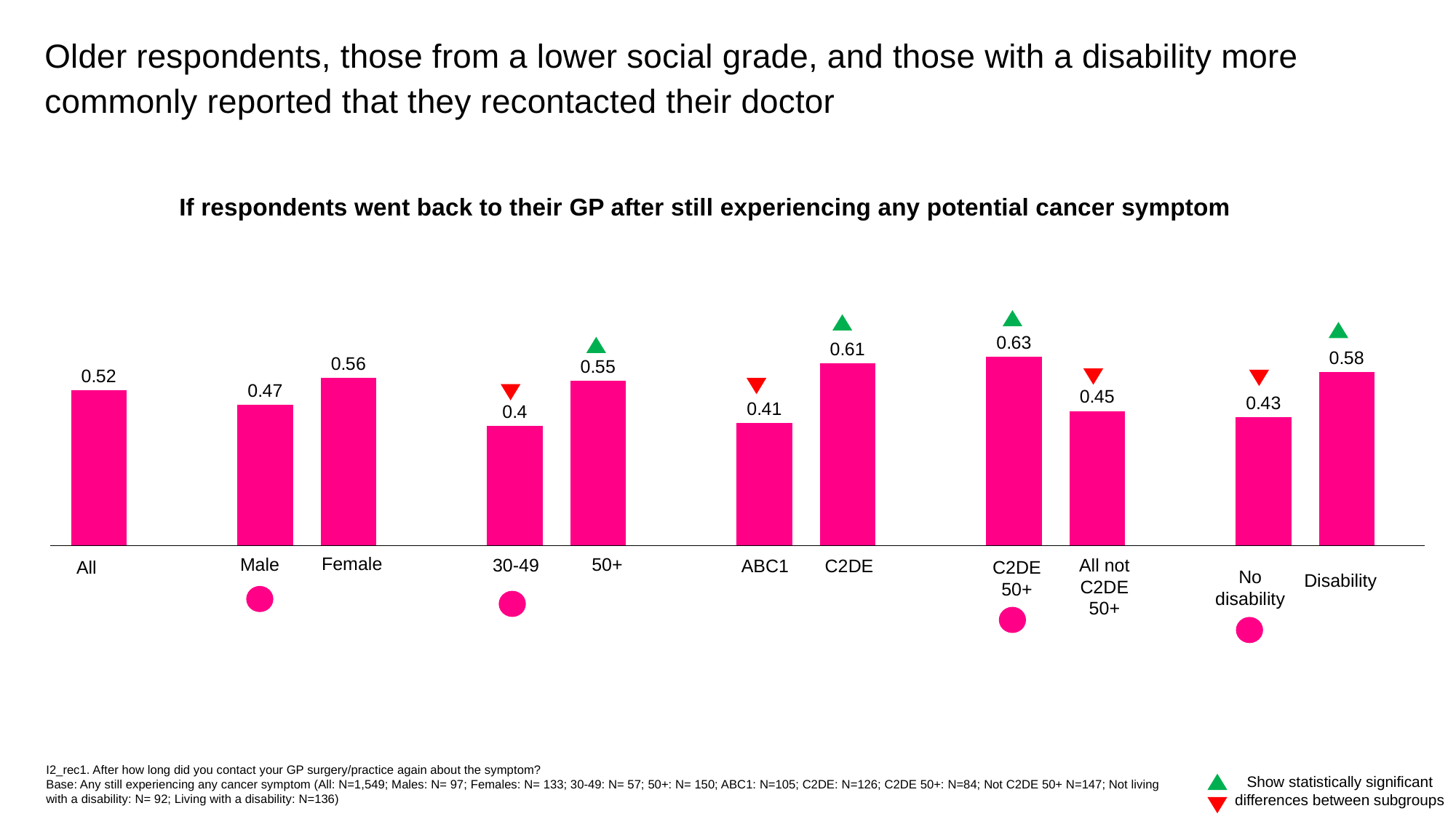
Which is larger, the value for 50+ or the value for 30-49? 50+ What is the value for the C2DE category? 0.61 What is the difference between the values for C2DE and ABC1? 0.2 How many bars are plotted in the chart? 11 What is the value for the 30-49 category? 0.4 What is the difference between the values for Female and Male? 0.09 What is the value for the Disability category? 0.58 Which category has the lowest value? 30-49 What kind of chart is shown on the slide? Bar chart Which category has the highest value? C2DE 50+ What is the value for the All category? 0.52 What is the title of the chart? If respondents went back to their GP after still experiencing any potential cancer symptom